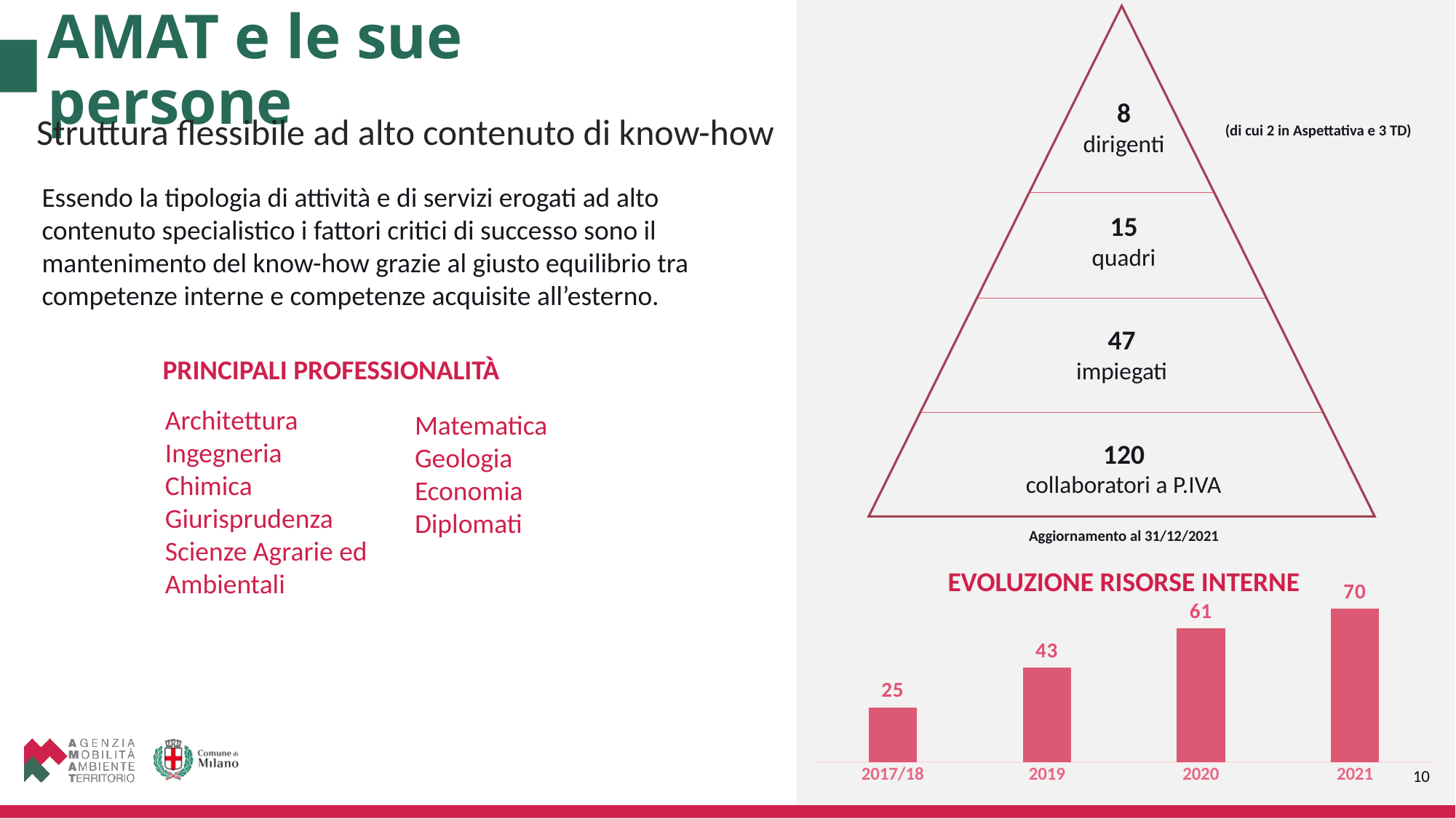
In the 'EVOLUZIONE RISORSE INTERNE' chart, what is the value for 2017/18? 25 How many bars are shown in the 'EVOLUZIONE RISORSE INTERNE' chart? 4 In the 'EVOLUZIONE RISORSE INTERNE' chart, which period has the lowest value? 2017/18 In the 'EVOLUZIONE RISORSE INTERNE' chart, what is the value for 2019? 43 What kind of chart is 'EVOLUZIONE RISORSE INTERNE'? bar chart In the 'EVOLUZIONE RISORSE INTERNE' chart, what is the value for 2021? 70 In the 'EVOLUZIONE RISORSE INTERNE' chart, what is the difference between the values for 2021 and 2017/18? 45 In the 'EVOLUZIONE RISORSE INTERNE' chart, which period has the highest value? 2021 In the 'EVOLUZIONE RISORSE INTERNE' chart, what is the difference between the values for 2020 and 2019? 18 In the 'EVOLUZIONE RISORSE INTERNE' chart, do the values rise or fall from 2017/18 to 2021? rise In the 'EVOLUZIONE RISORSE INTERNE' chart, which is larger, the value for 2019 or the value for 2020? 2020 In the 'EVOLUZIONE RISORSE INTERNE' chart, what is the value for 2020? 61